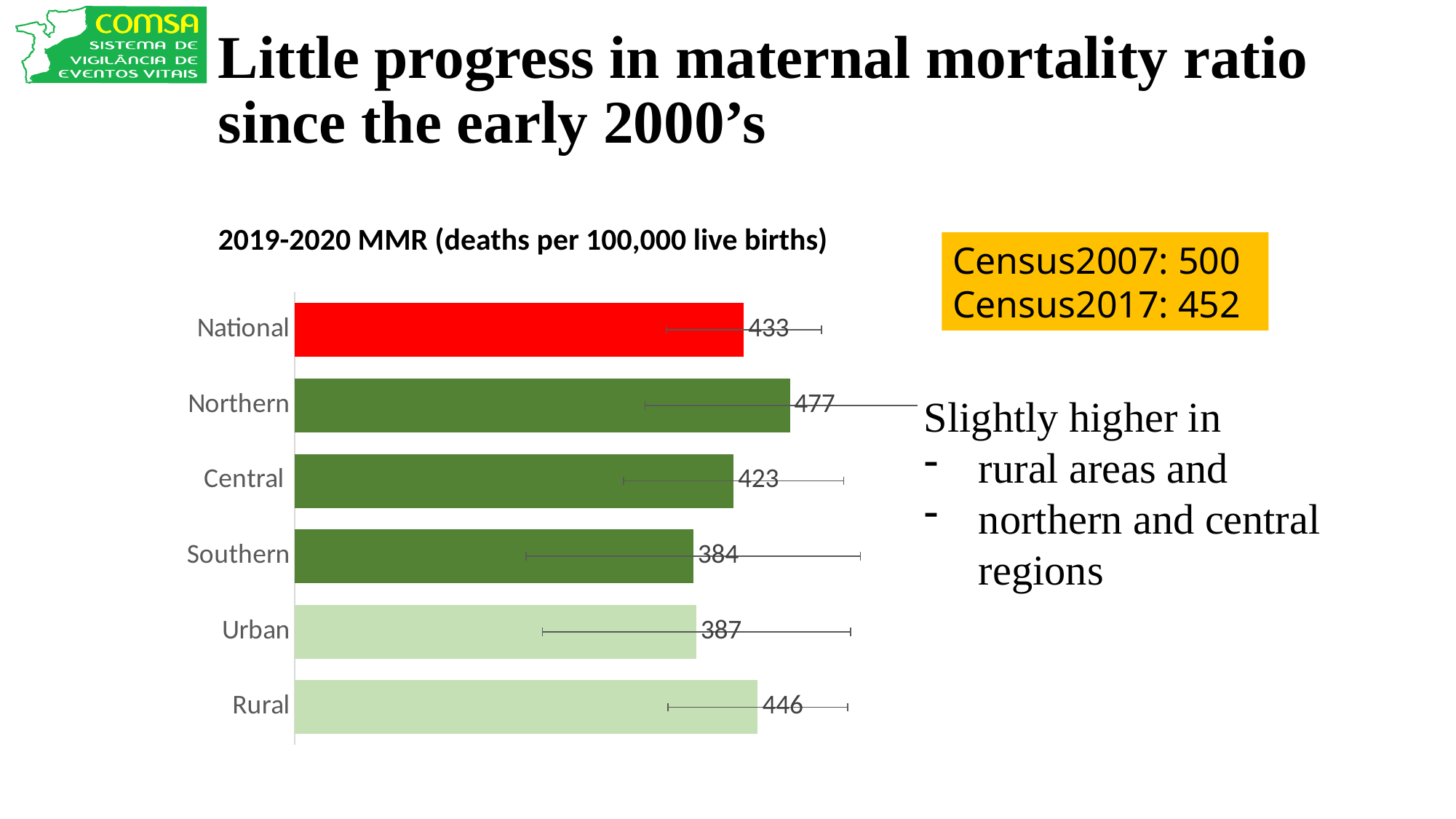
What is the 2019-2020 MMR value for the National category? 433 Which category has the highest MMR value in the chart? Northern What kind of chart is shown on the slide? Bar chart What is the MMR value shown for the Northern region? 477 What is the difference between the Rural and Urban MMR values? 59 Which category has the lowest MMR value in the chart? Southern How many categories are shown in the bar chart? 6 What is the difference between the Northern and Central MMR values? 54 What is the title of the chart? 2019-2020 MMR (deaths per 100,000 live births) What is the MMR value shown for Rural areas? 446 Which has a higher MMR value, Rural or National? Rural Which has a higher MMR value, Central or Southern? Central